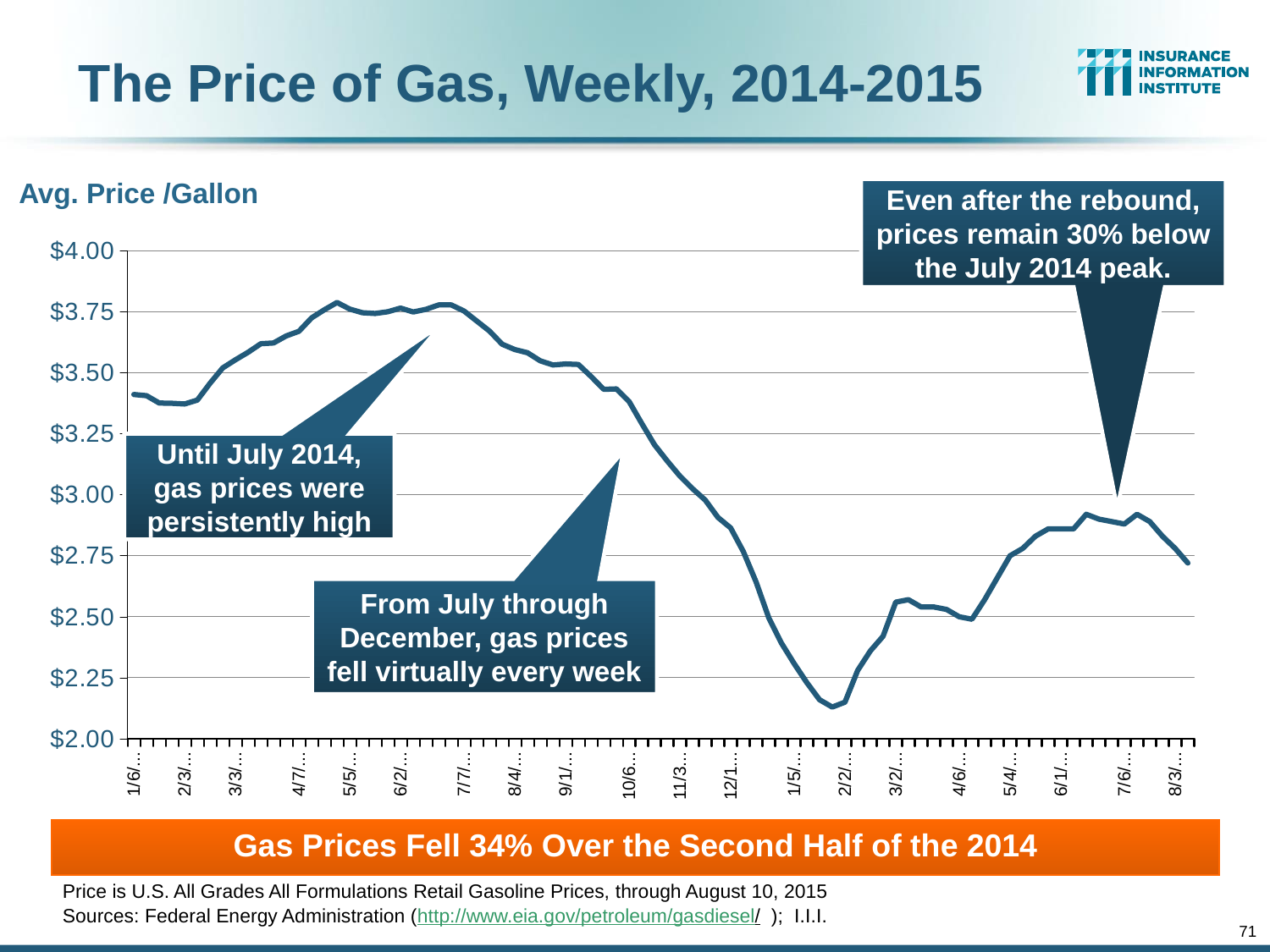
Do gas prices rise or fall between 2/2 and 6/1? rise Is the value at 1/6 greater or less than $3.25? greater What kind of chart is shown on the slide? line chart Is the value at 12/1 greater or less than $3.00? less What is the title of the chart on the slide? The Price of Gas, Weekly, 2014-2015 Is the value at 7/7 greater or less than $3.50? greater What label is given to the vertical axis of the chart? Avg. Price /Gallon Which of the labeled dates, 7/7 or 2/2, has the higher gas price? 7/7 Do gas prices rise or fall between 7/7 and 2/2? fall